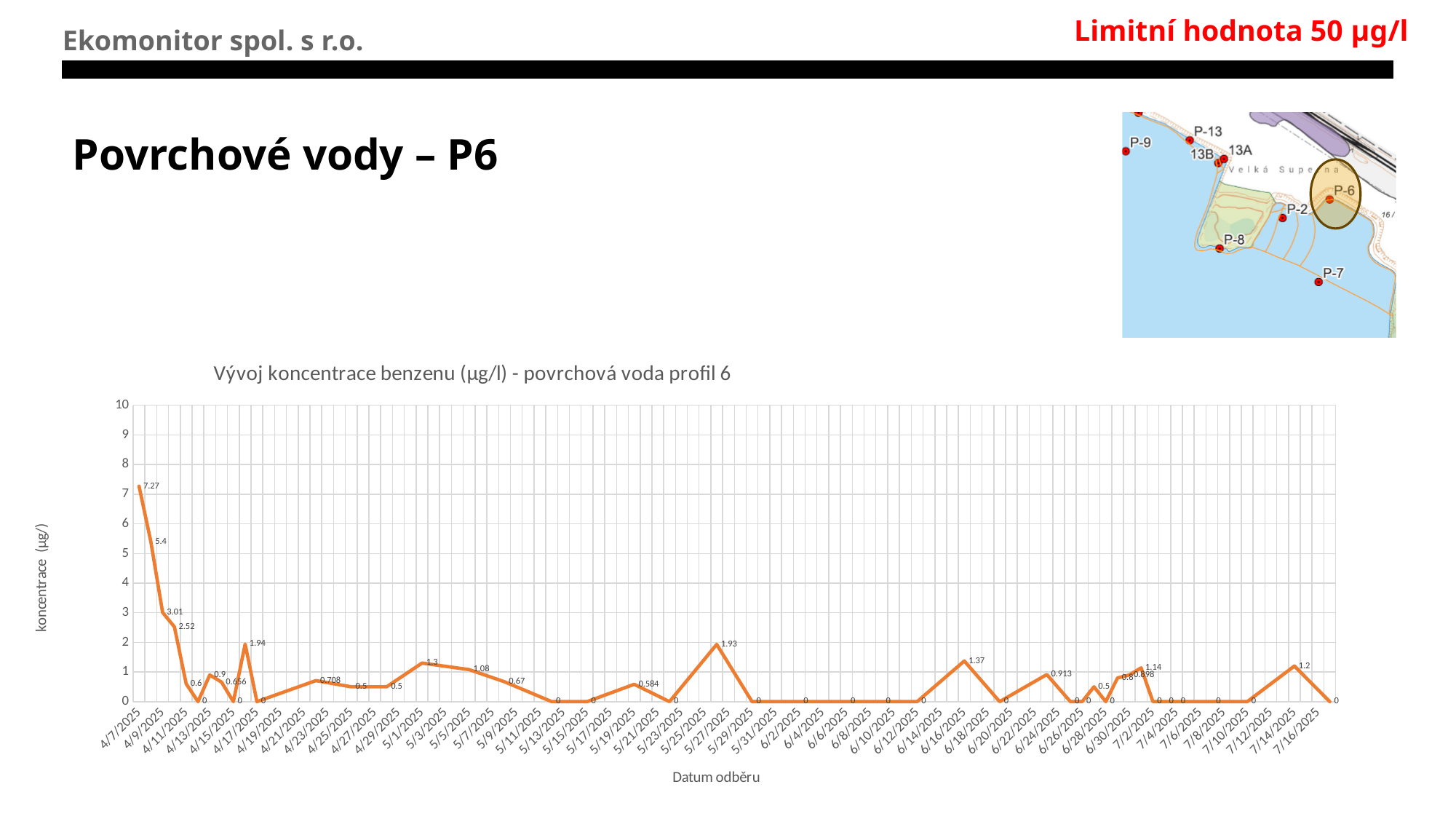
What is the benzene concentration on 7/14/2025? 1.2 What is the title of the chart? Vývoj koncentrace benzenu (µg/l) - povrchová voda profil 6 What is the benzene concentration on 4/7/2025? 7.27 What is the benzene concentration on 6/16/2025? 1.37 What is the difference between the concentration on 4/7/2025 (7.27) and on 4/9/2025 (3.01)? 4.26 What is the label of the x axis of the chart? Datum odběru What kind of chart is shown on the slide? Line chart On which date is the benzene concentration highest? 4/7/2025 Is the value for 4/7/2025 greater or less than 5? greater